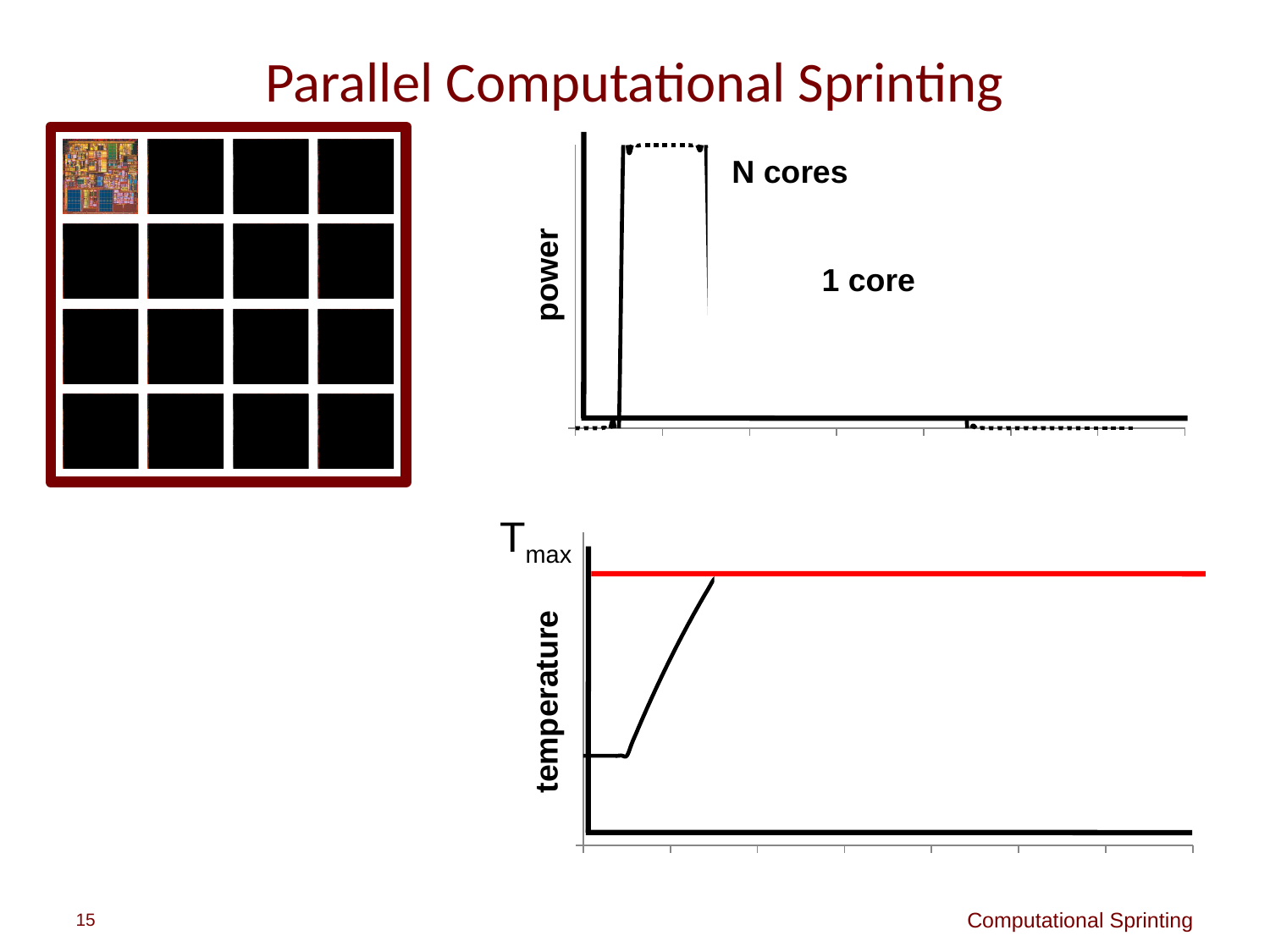
What kind of chart is the bottom chart labeled 'temperature'? line chart What is the y-axis label of the top chart? power How many charts are shown on the slide? 2 In the bottom chart, does the temperature line rise or fall after its initial flat segment? rise In the top chart, how many series are labeled? 2 In the top chart, does the solid power line rise or fall at the start of the sprint? rise What kind of chart is the top chart labeled 'power'? line chart What is the y-axis label of the bottom chart? temperature